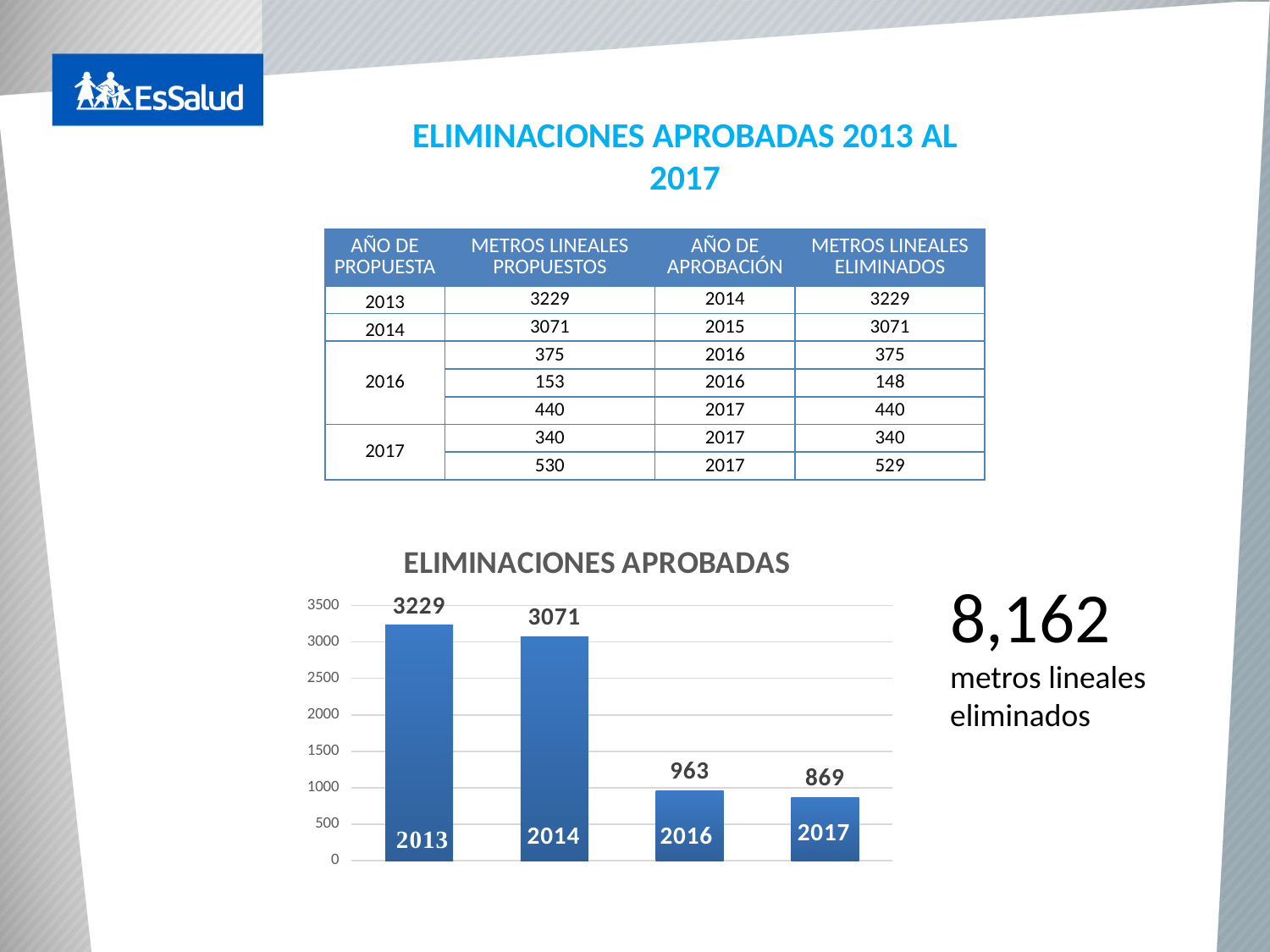
How many years are shown in the ELIMINACIONES APROBADAS chart? 4 Which year has the lowest value in the ELIMINACIONES APROBADAS chart? 2017 Do the values in the ELIMINACIONES APROBADAS chart rise or fall from 2013 to 2017? fall What is the value for 2013 in the ELIMINACIONES APROBADAS chart? 3229 Which is larger in the ELIMINACIONES APROBADAS chart, the value for 2014 or the value for 2016? 2014 What is the value for 2017 in the ELIMINACIONES APROBADAS chart? 869 What is the difference between the values for 2016 and 2017 in the ELIMINACIONES APROBADAS chart? 94 Is the value for 2016 in the ELIMINACIONES APROBADAS chart greater or less than 1000? less What kind of chart is the ELIMINACIONES APROBADAS chart? bar chart Which year has the highest value in the ELIMINACIONES APROBADAS chart? 2013 What is the difference between the values for 2013 and 2014 in the ELIMINACIONES APROBADAS chart? 158 What is the value for 2016 in the ELIMINACIONES APROBADAS chart? 963